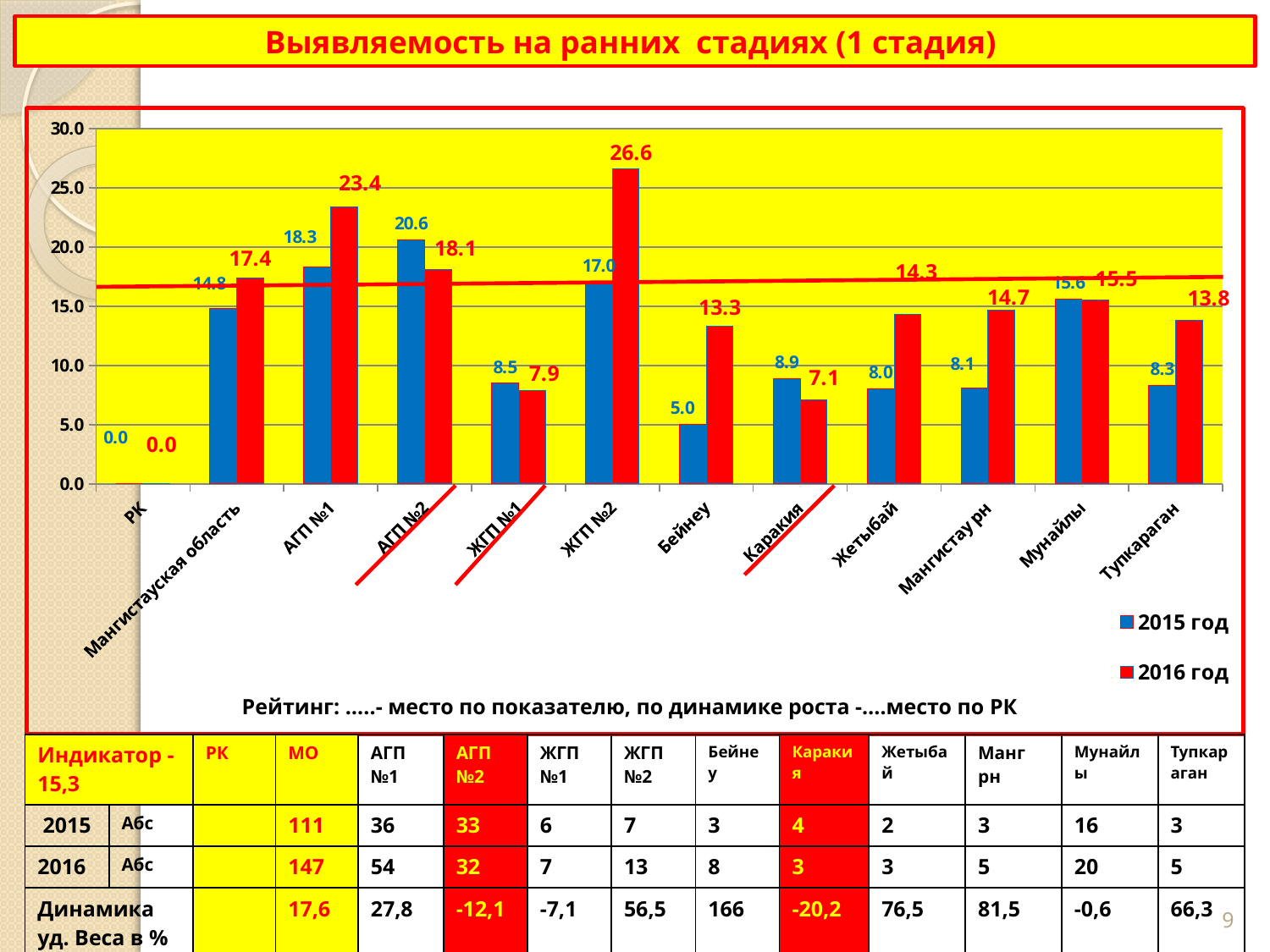
What is the difference between the 2016 год and 2015 год values for АГП №1? 5.1 For АГП №2, which is larger: the 2015 год value or the 2016 год value? 2015 год Which category has the highest 2016 год value? ЖГП №2 What kind of chart is shown on the slide? Bar chart What is the 2016 год value for ЖГП №2? 26.6 How many categories are shown on the x axis of the chart? 12 What is the 2015 год value for АГП №2? 20.6 What is the 2016 год value for Мангистауская область? 17.4 What is the 2015 год value for Бейнеу? 5.0 What is the difference between the 2016 год and 2015 год values for ЖГП №2? 9.6 How many series does the legend list? 2 Which category has the highest 2015 год value? АГП №2